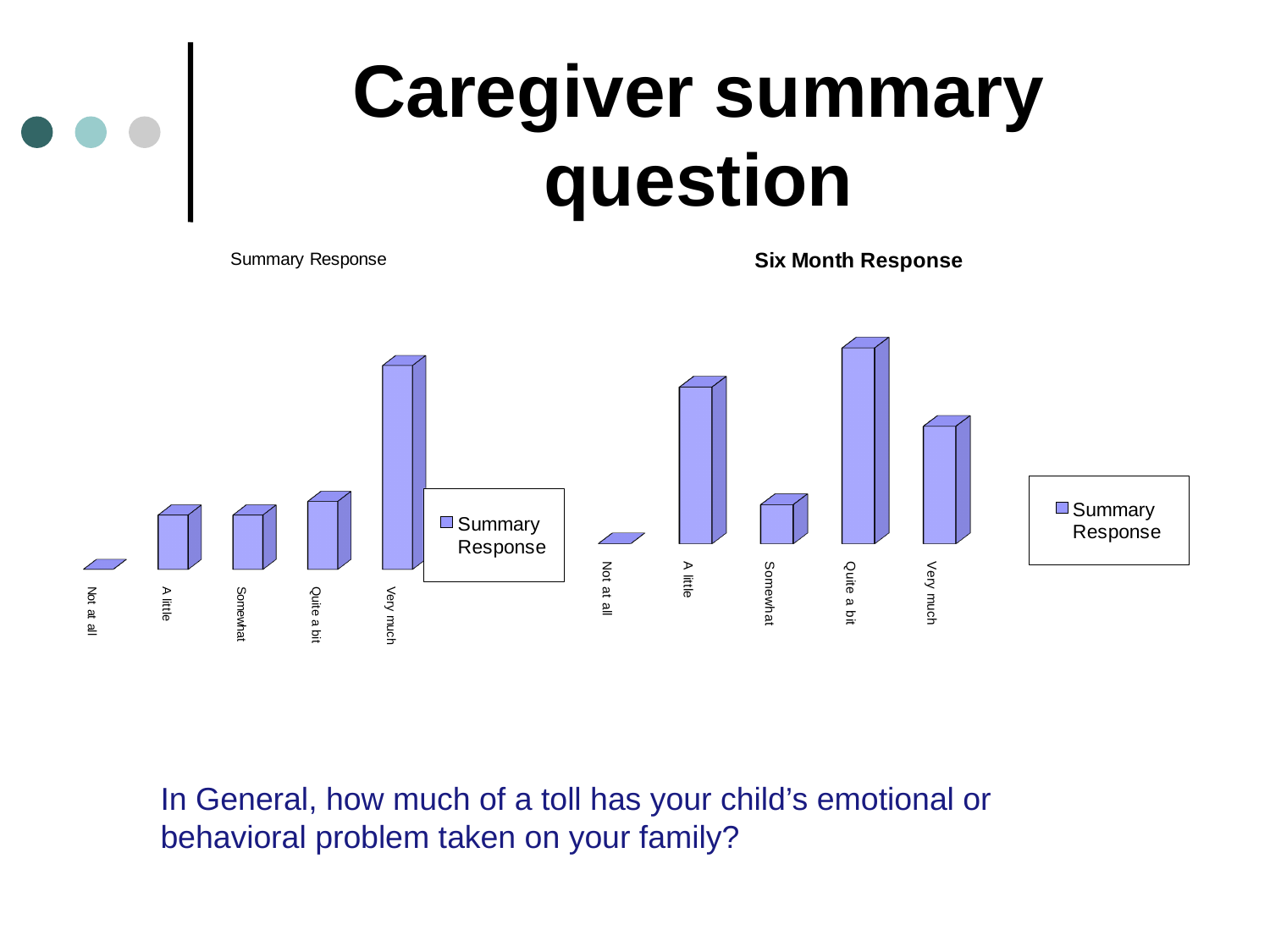
How many series does the legend of the Six Month Response chart list? 1 What is the legend entry shown in the Summary Response chart? Summary Response What kind of chart is the Summary Response chart? Bar chart In the Six Month Response chart, which category has the highest bar? Quite a bit How many categories are shown on the x axis of the Summary Response chart? 5 How many categories are shown on the x axis of the Six Month Response chart? 5 In the Six Month Response chart, which is larger, the bar for A little or the bar for Somewhat? A little In the Summary Response chart, which category has the highest bar? Very much In the Six Month Response chart, which category has the lowest bar? Not at all In the Summary Response chart, which is larger, the bar for Very much or the bar for A little? Very much In the Six Month Response chart, which is larger, the bar for Quite a bit or the bar for Very much? Quite a bit In the Summary Response chart, which category has the lowest bar? Not at all